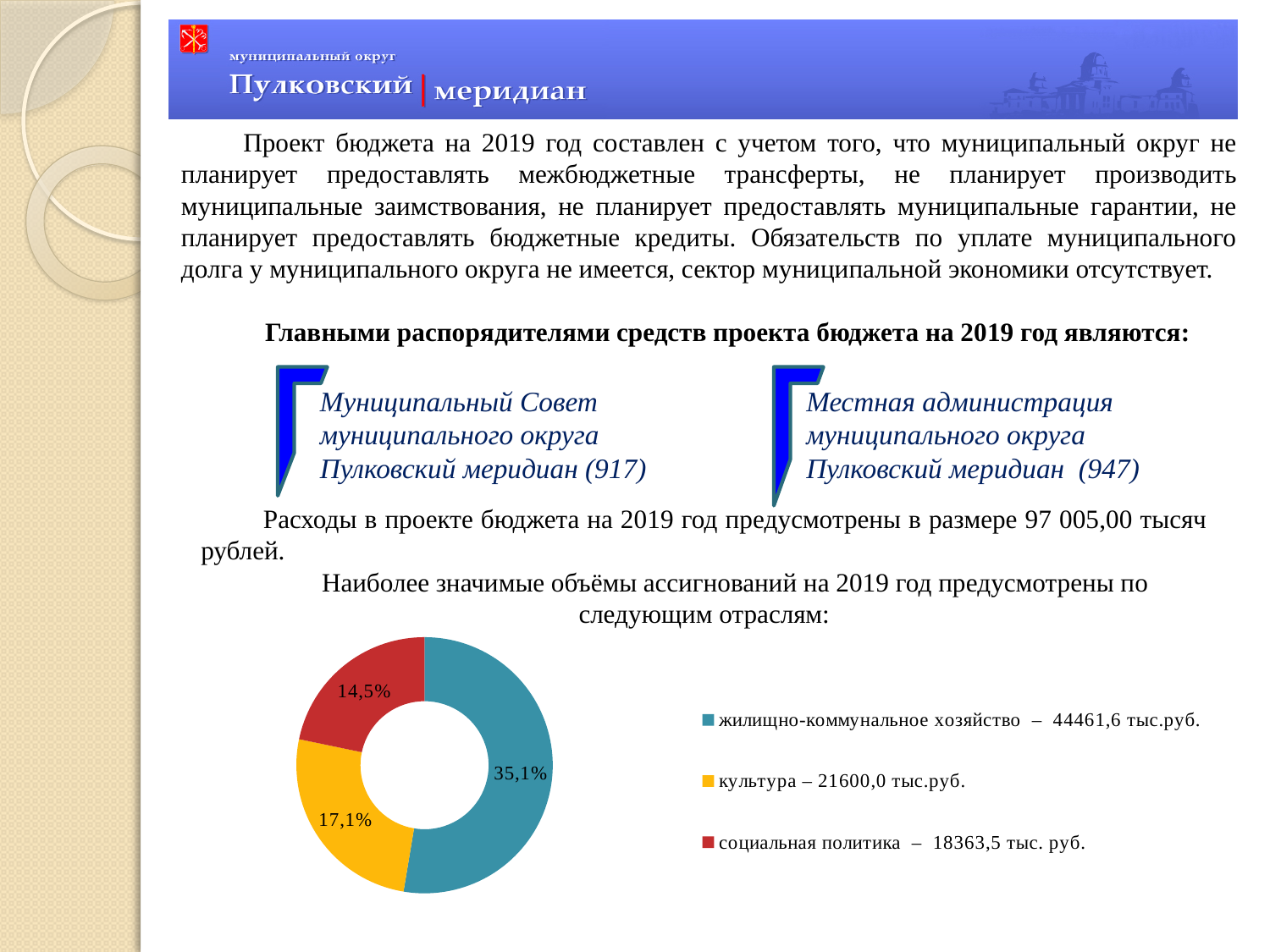
Which sector has the smallest slice in the chart? социальная политика What percentage is shown on the slice for культура? 17,1% Which colour represents культура in the chart? Yellow How many entries does the legend of the chart list? 3 What kind of chart is shown on the slide? Doughnut (pie) chart According to the legend, what amount in thousand rubles is allocated to культура? 21600,0 тыс.руб. Which sector has the largest slice in the chart? жилищно-коммунальное хозяйство What percentage is shown on the slice for социальная политика? 14,5% What percentage is shown on the slice for жилищно-коммунальное хозяйство? 35,1% According to the legend, what amount in thousand rubles is allocated to социальная политика? 18363,5 тыс. руб. How many slices does the doughnut chart have? 3 What is the difference in percentage points between the жилищно-коммунальное хозяйство slice and the культура slice? 18,0%